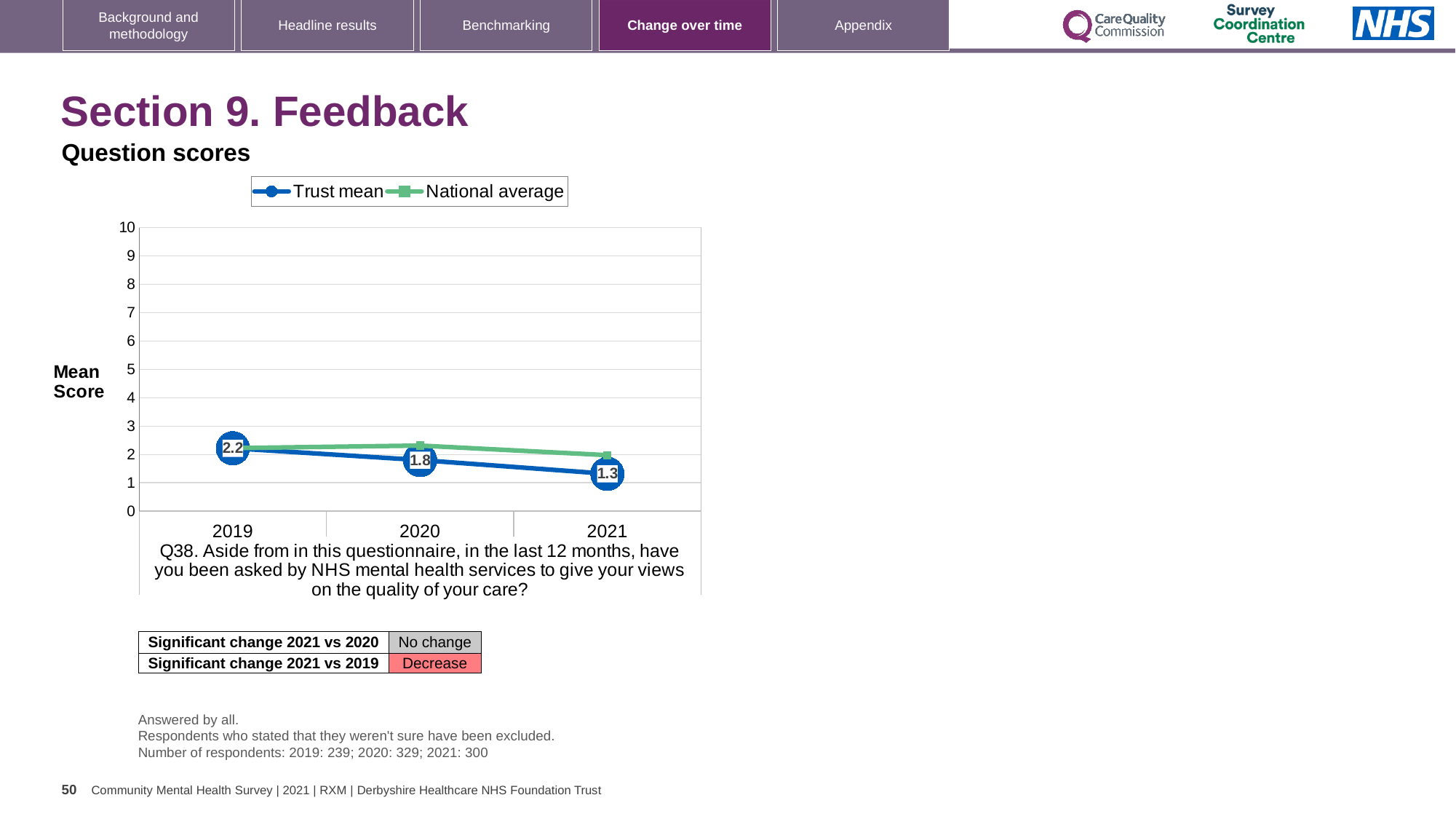
What kind of chart is shown on the slide? Line chart In 2021, which is higher: the Trust mean or the National average? National average In which year is the Trust mean score lowest? 2021 What is the difference between the Trust mean score in 2019 and in 2021? 0.9 How many years are shown on the x axis of the chart? 3 What is the Trust mean score for 2021? 1.3 Does the Trust mean score rise or fall from 2019 to 2021? Fall Is the National average for 2020 greater or less than 3? less What is the Trust mean score for 2019? 2.2 In which year is the Trust mean score highest? 2019 How many series does the chart legend list? 2 What is the Trust mean score for 2020? 1.8